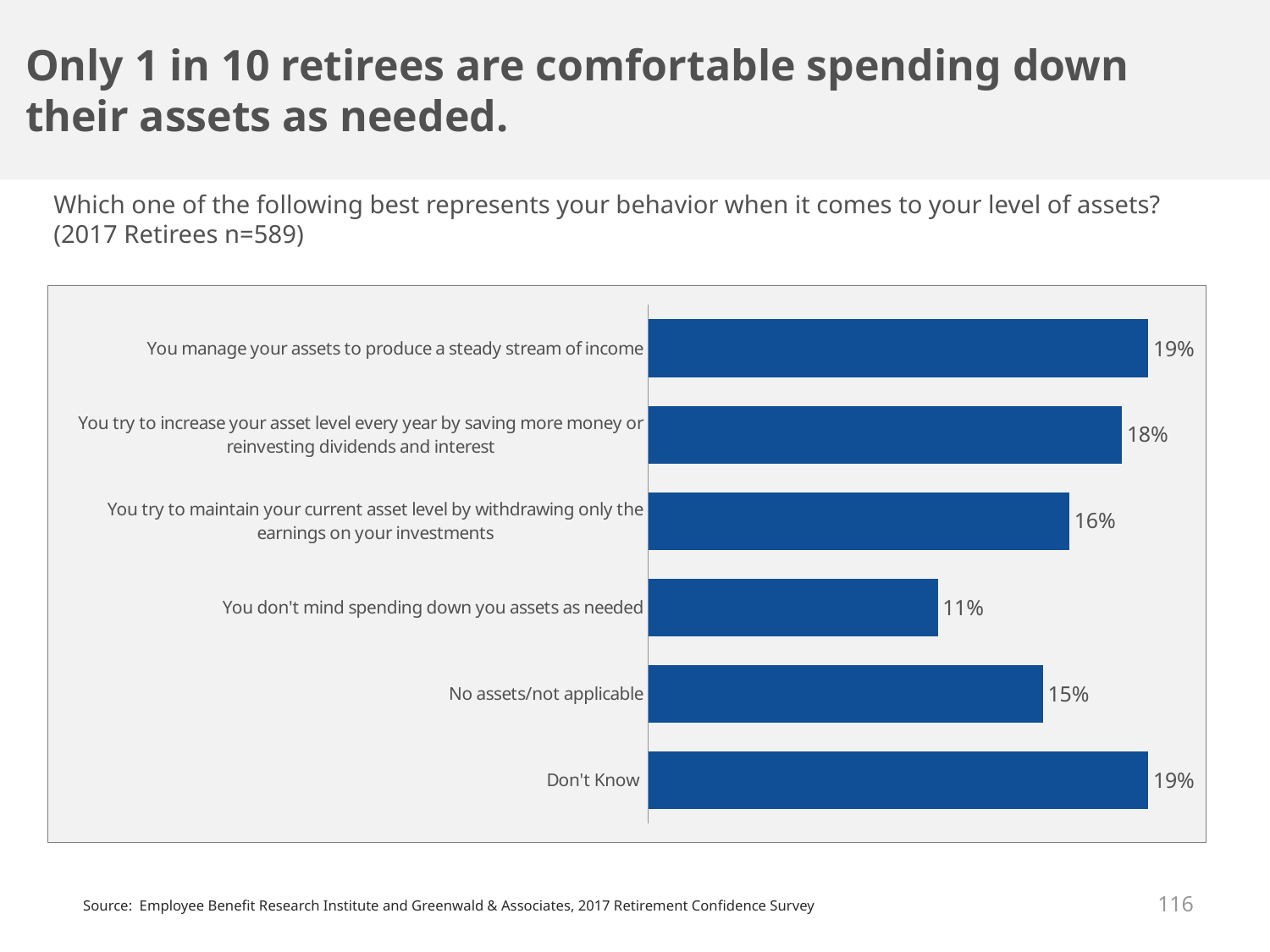
What is the difference between the percentage who try to increase their asset level every year and the percentage who don't mind spending down their assets as needed? 7% Which is larger: the value for "No assets/not applicable" or the value for "You try to maintain your current asset level by withdrawing only the earnings on your investments"? You try to maintain your current asset level by withdrawing only the earnings on your investments What is the sample size of retirees shown in the chart's question text? n=589 What type of chart is shown on the slide? Bar chart What is the difference between the value for "Don't Know" and the value for "No assets/not applicable"? 4% Which response has the lowest percentage? You don't mind spending down you assets as needed What percentage of retirees answered "Don't Know"? 19% What is the value for "No assets/not applicable"? 15% What percentage of retirees say they don't mind spending down their assets as needed? 11% How many response categories are shown in the chart? 6 What percentage of retirees say they manage their assets to produce a steady stream of income? 19% What is the value for retirees who try to maintain their current asset level by withdrawing only the earnings on their investments? 16%